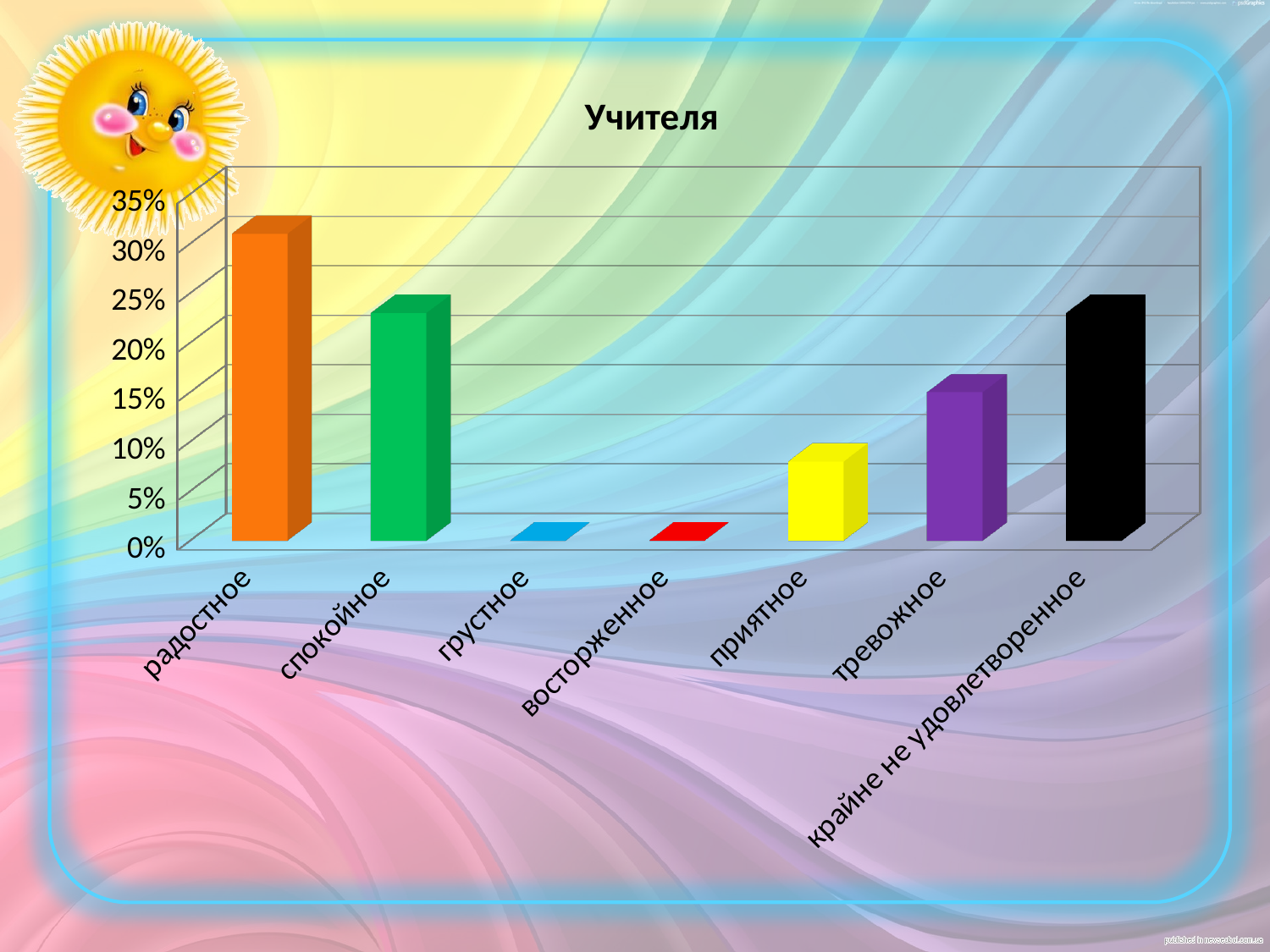
What colour is the bar for радостное? orange Is the value for крайне не удовлетворенное greater or less than 20%? greater Which category has the highest bar in the chart? радостное How many categories are shown on the x axis of the chart? 7 Which is larger, the value for радостное or the value for спокойное? радостное Is the value for тревожное greater or less than 10%? greater Is the value for радостное greater or less than 25%? greater Which is larger, the value for тревожное or the value for приятное? тревожное What kind of chart is shown on the slide? bar chart What is the title of the chart? Учителя